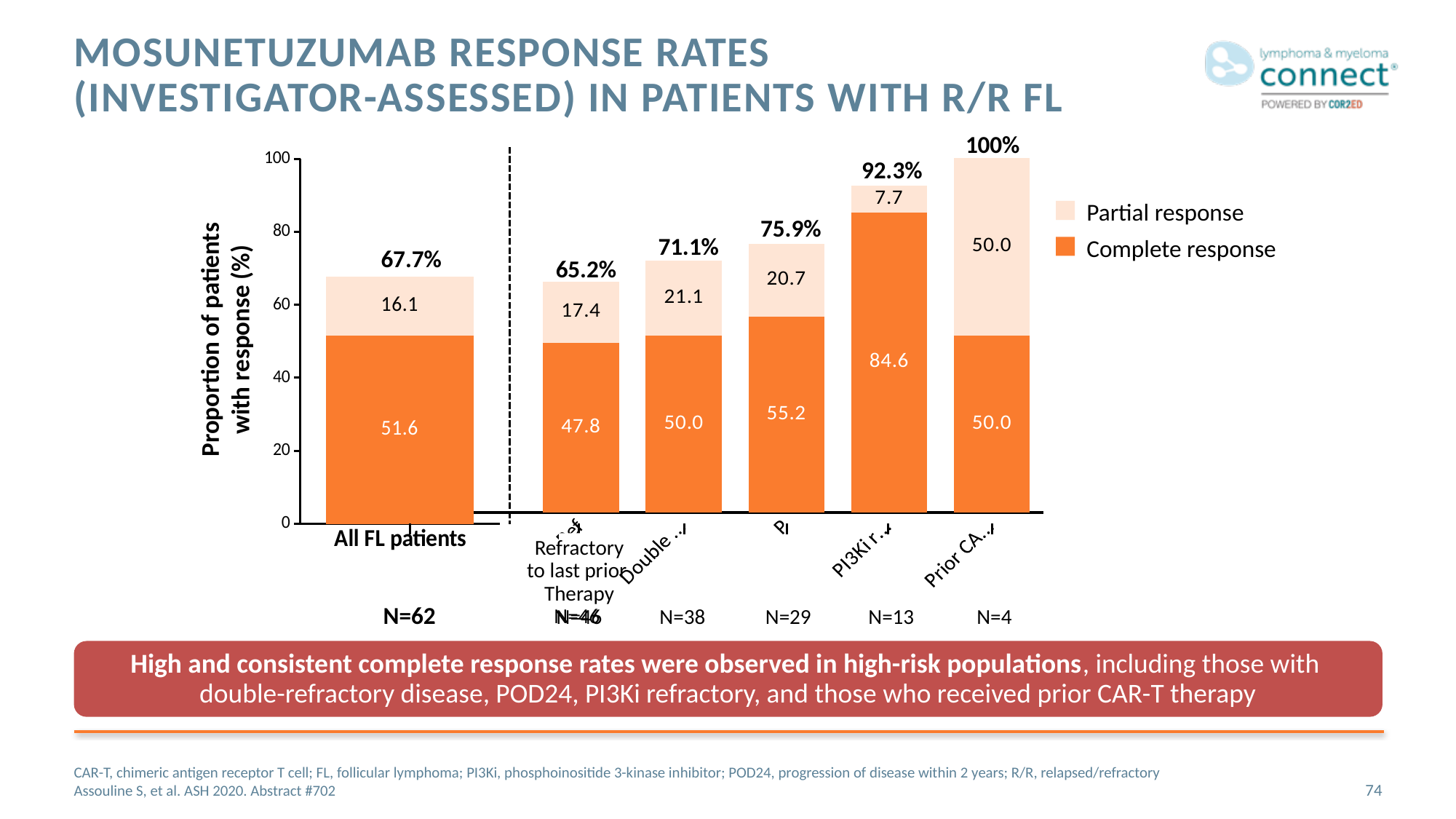
What is the total response rate shown above the bar for patients refractory to last prior therapy? 65.2% What is the partial response value for All FL patients? 16.1 Which bar has the highest total response rate? The N=4 bar (100%) What is the total response rate shown above the All FL patients bar? 67.7% Which legend entry is shown in the darker orange colour? Complete response What is the difference in complete response between All FL patients and patients refractory to last prior therapy? 3.8 What is the complete response value for All FL patients? 51.6 What kind of chart is shown on the slide? Stacked bar chart How many bars are plotted in the chart? 6 How many series does the legend list? 2 What is the complete response value for patients refractory to last prior therapy? 47.8 Which is larger, the partial response for All FL patients or for patients refractory to last prior therapy? Refractory to last prior therapy